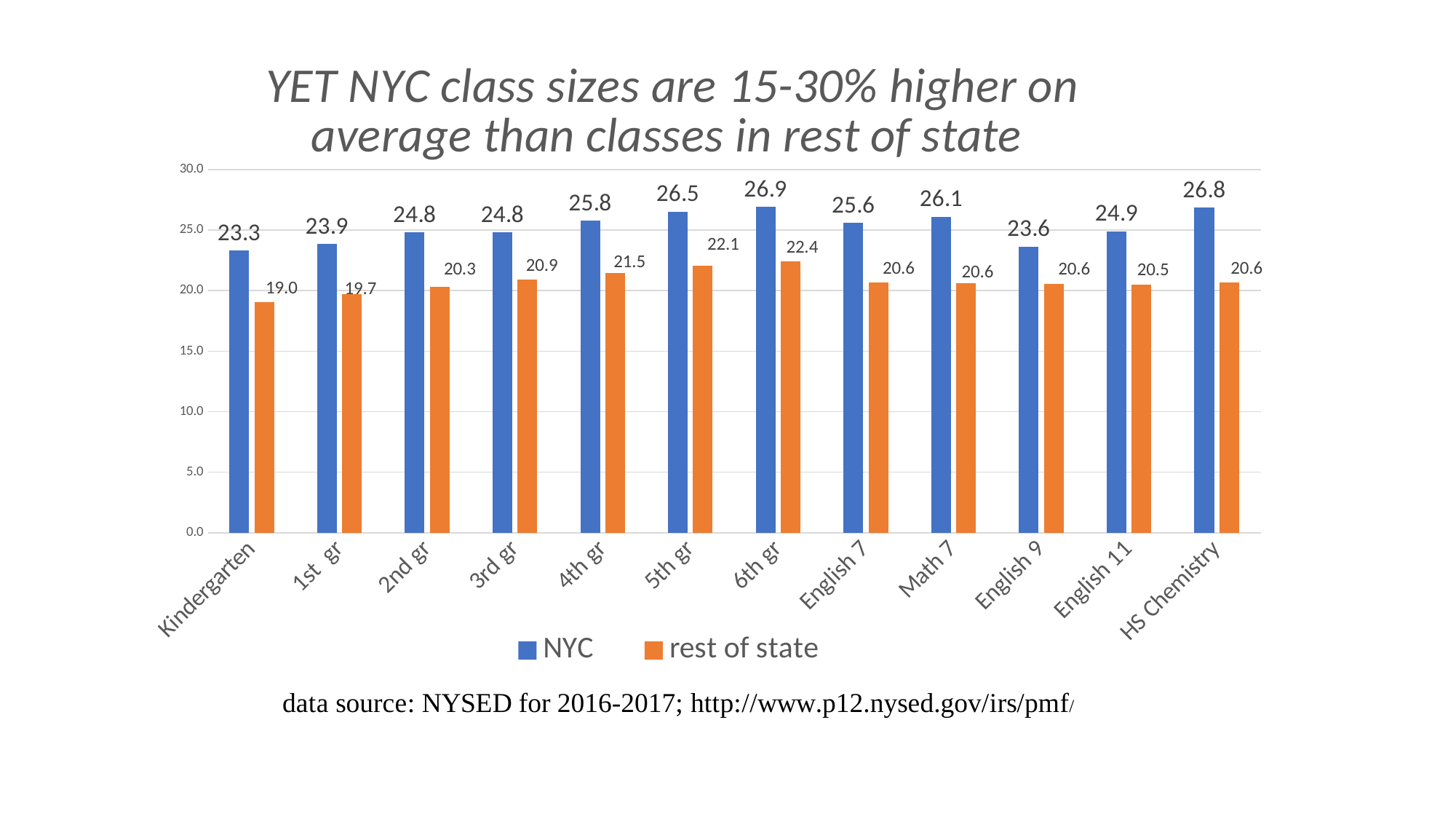
How many series does the legend list? 2 What is the rest of state class size for 6th gr? 22.4 Which category has the lowest rest of state class size? Kindergarten Which is larger, the NYC class size for Math 7 or the NYC class size for English 9? Math 7 What kind of chart is shown on the slide? bar chart What is the NYC class size for HS Chemistry? 26.8 Which category has the highest NYC class size? 6th gr What is the NYC class size for Kindergarten? 23.3 What is the difference between the NYC and rest of state class sizes for 5th gr? 4.4 Which colour represents the rest of state series? orange How many categories are shown on the x axis? 12 Is the rest of state class size for 1st gr greater or less than 20.0? less